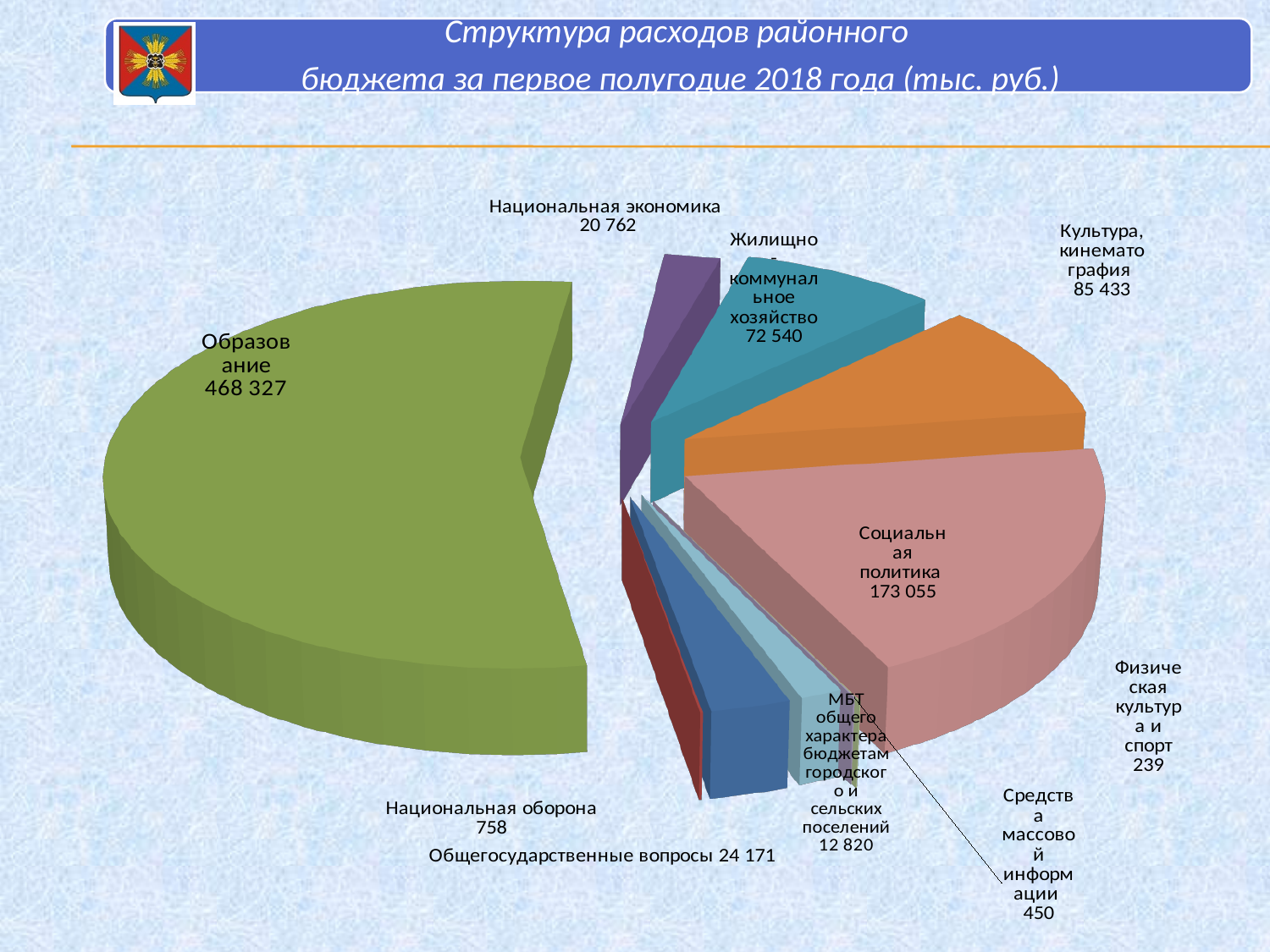
What is the difference between Социальная политика and Культура, кинематография? 87 622 What is the value for Национальная оборона? 758 How many categories are shown in the pie chart? 10 What is the value for Образование? 468 327 What type of chart is shown on the slide? Pie chart What is the value for МБТ общего характера бюджетам городского и сельских поселений? 12 820 What is the difference between Общегосударственные вопросы and Национальная экономика? 3 409 Which category has the smallest value? Физическая культура и спорт What is the value for Социальная политика? 173 055 Which category has the largest value? Образование Which is larger: Средства массовой информации or Физическая культура и спорт? Средства массовой информации What is the value for Жилищно-коммунальное хозяйство? 72 540